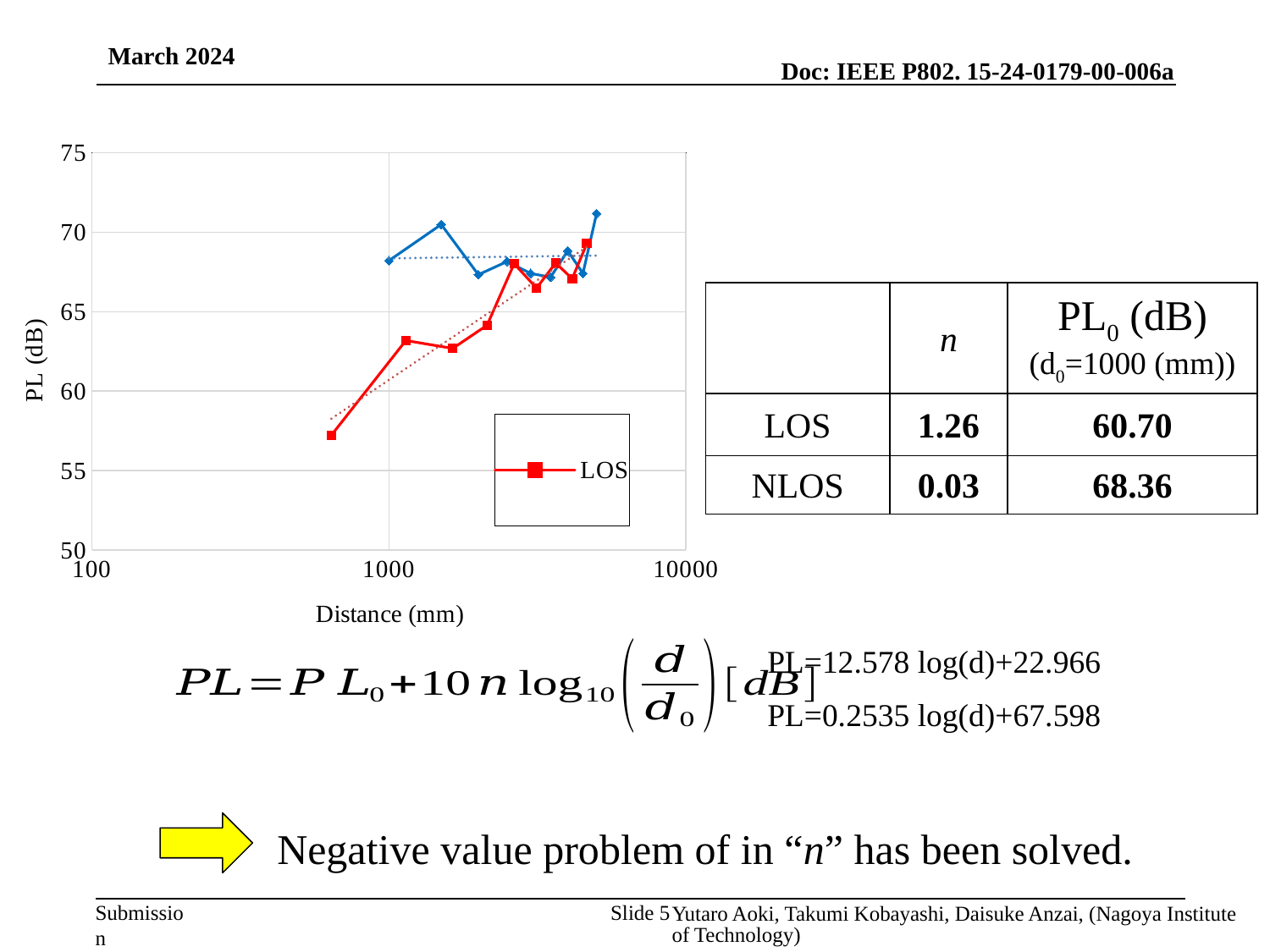
Which series reaches the highest PL value on the chart, the red LOS series or the blue series? the blue series Is the LOS value at the smallest plotted distance greater or less than 60? less At a distance of about 1000 mm, which series has the higher PL value, the red LOS series or the blue series? the blue series How many series does the chart's legend list? 1 Do the LOS values generally rise or fall as distance increases along the x axis? rise Is the value of the blue series at its largest plotted distance greater or less than 70? greater What kind of chart is shown on the slide? line chart What is the series name shown in the chart's legend? LOS What is the label of the chart's vertical axis? PL (dB) Is the LOS value at the largest plotted distance greater or less than 65? greater